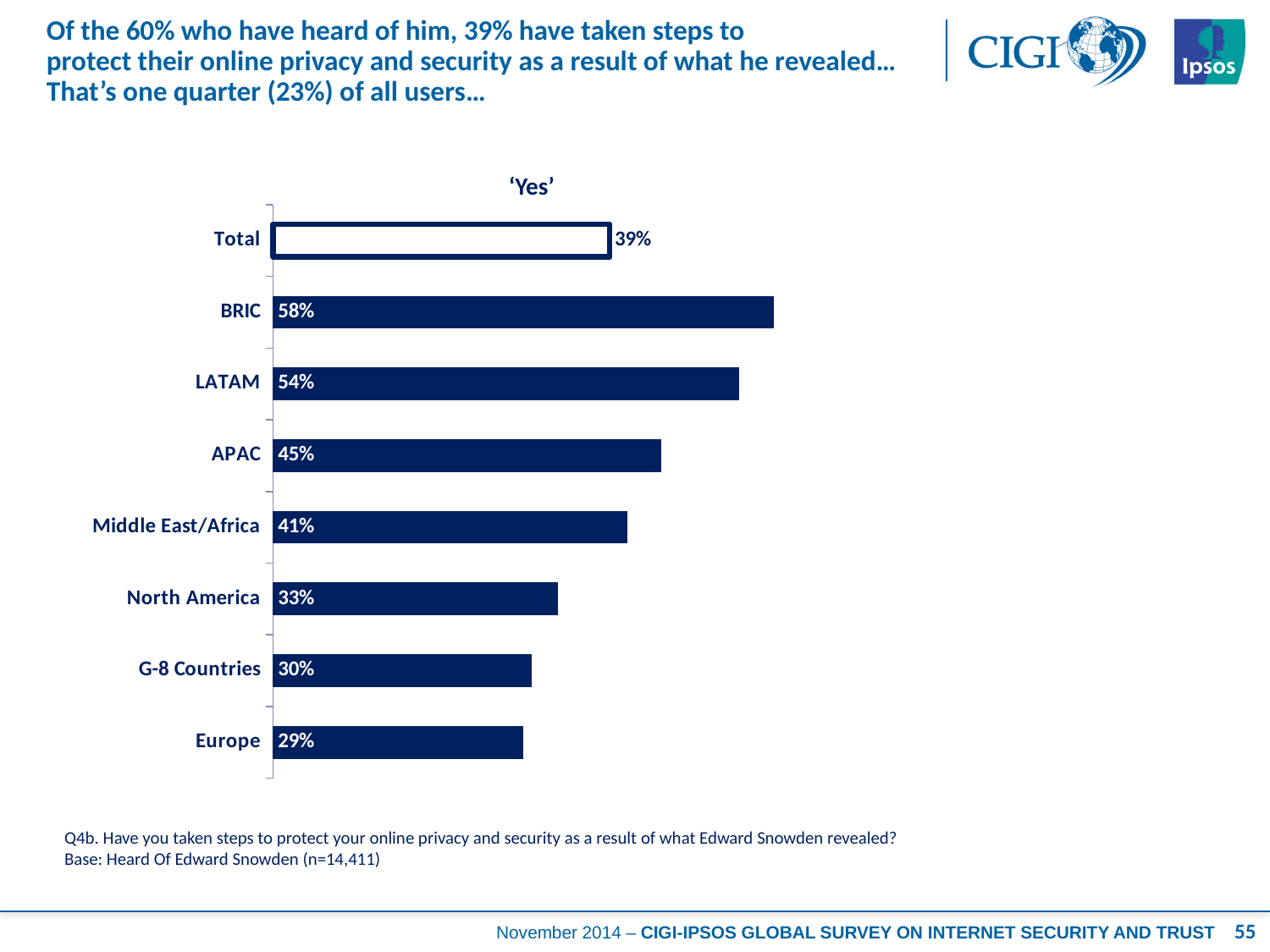
Which region has the lowest value? Europe What is the title shown above the chart? 'Yes' What is the value for Middle East/Africa? 41% What is the value for Europe? 29% What is the value for BRIC? 58% What is the difference between the values for BRIC and Europe? 29% Which is larger, the value for North America or the value for G-8 Countries? North America Which region has the highest value? BRIC What is the value for the Total bar? 39% What kind of chart is shown on the slide? Bar chart How many bars are shown in the chart? 8 What is the difference between the values for LATAM and APAC? 9%